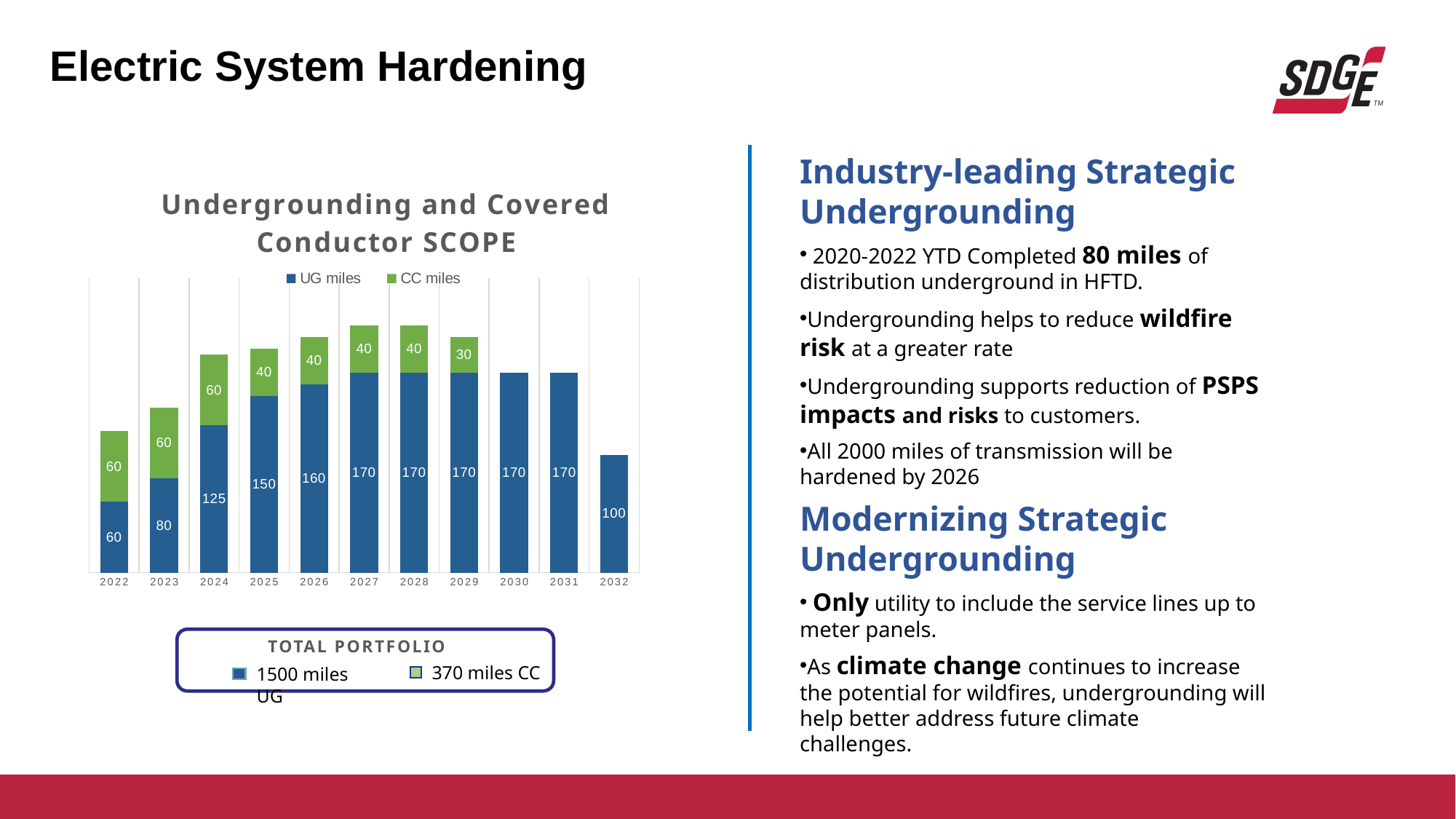
Which is larger, the CC miles value for 2024 or the CC miles value for 2027? 2024 What is the CC miles value for 2029? 30 What is the total of the stacked bar for 2022? 120 What is the total of the stacked bar for 2026? 200 What is the UG miles value for 2024? 125 What is the title of the chart? Undergrounding and Covered Conductor SCOPE What is the UG miles value for 2032? 100 What is the difference between UG miles in 2025 and UG miles in 2022? 90 How many series does the legend list? 2 Which year has the lowest UG miles value? 2022 How many years are shown on the x axis? 11 What kind of chart is shown? Stacked bar chart